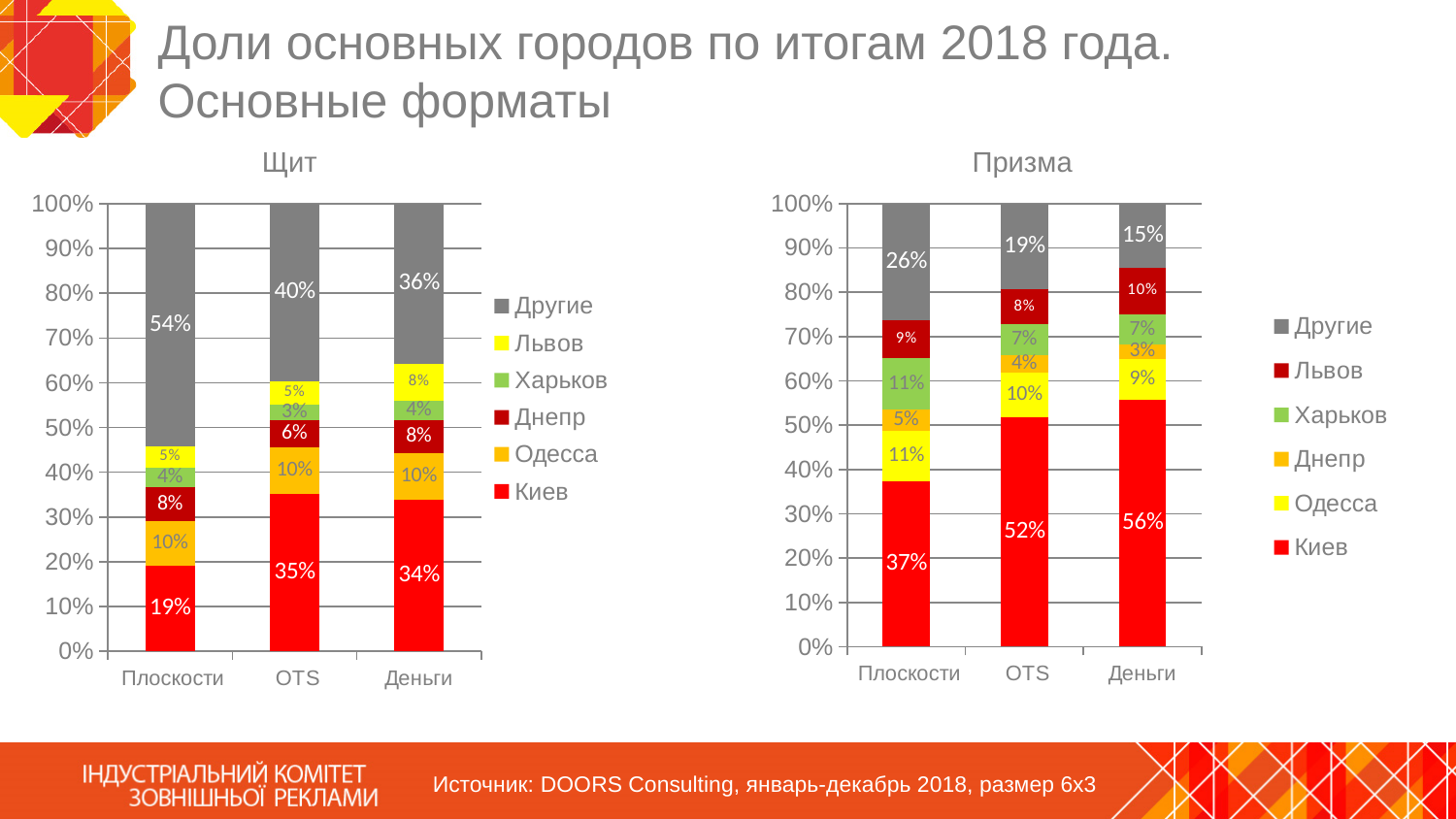
In the chart titled "Призма", which is larger: the Киев value for OTS or for Плоскости? OTS In the chart titled "Щит", which category has the highest value for Киев? OTS In the chart titled "Призма", what is the value for Киев in the Деньги bar? 56% In the chart titled "Призма", what colour represents Киев in the legend? Red In the chart titled "Щит", what is the value for Киев in the Плоскости bar? 19% In the chart titled "Призма", what is the value for Другие in the Плоскости bar? 26% How many series does the legend of the chart titled "Призма" list? 6 How many categories are shown on the x axis of the chart titled "Щит"? 3 In the chart titled "Щит", what is the value for Другие in the OTS bar? 40% What kind of chart is the chart titled "Щит"? Stacked bar chart In the chart titled "Призма", which category has the lowest value for Другие? Деньги In the chart titled "Щит", what is the difference between the Другие values for Плоскости and Деньги? 18%